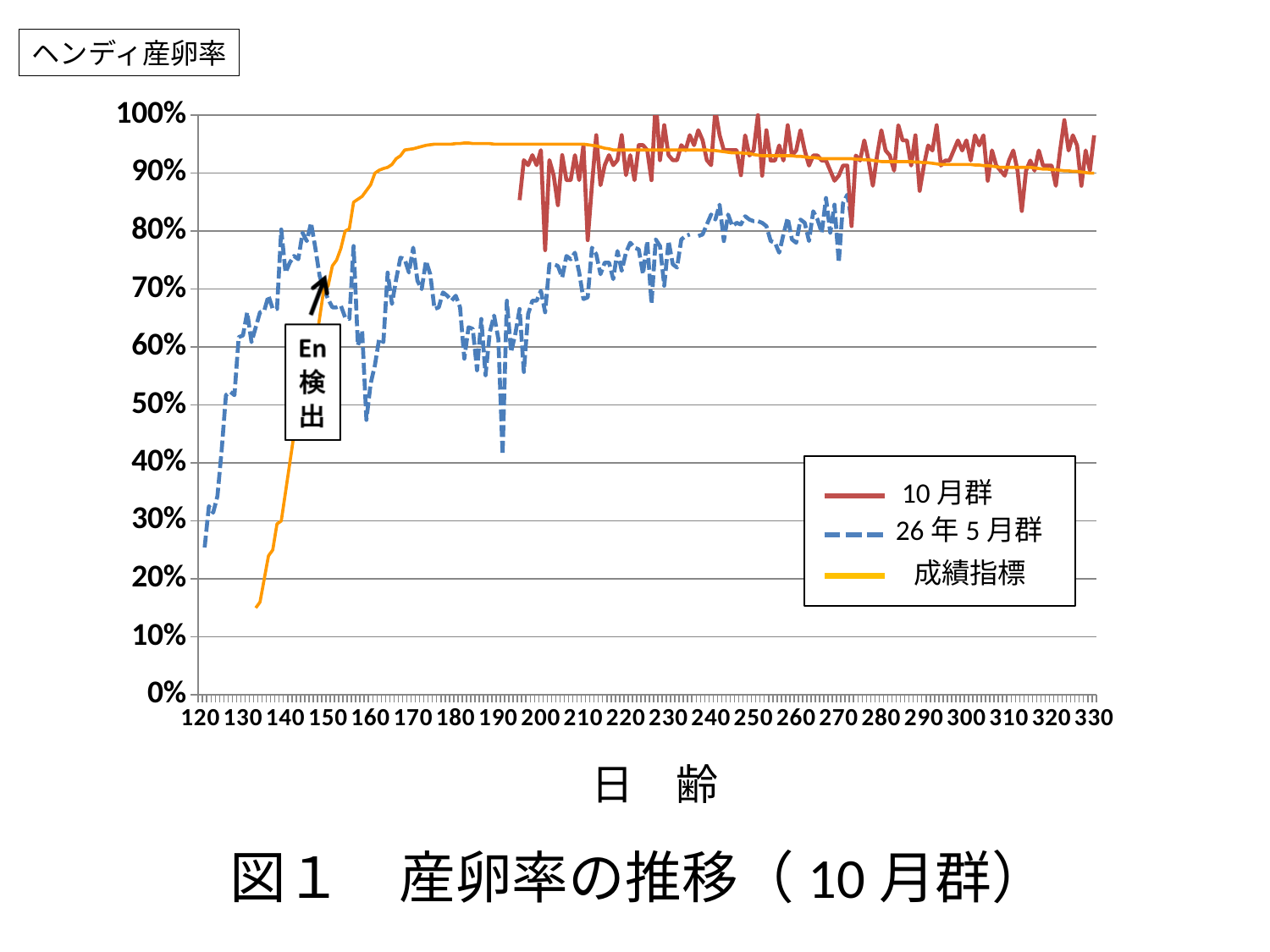
Is the value for 成績指標 at day 200 greater or less than 90%? greater What is the label of the x axis? 日齢 At day 250, which series has the higher value, 10月群 or 26年5月群? 10月群 Which series is drawn with a dashed line? 26年5月群 How many series does the legend list? 3 At day 140, which series has the higher value, 26年5月群 or 成績指標? 26年5月群 Is the lowest value for 26年5月群 around day 190 greater or less than 50%? less What kind of chart is shown on the slide? line chart Is the value for 10月群 at day 300 greater or less than 90%? greater Does the 成績指標 line rise or fall between day 134 and day 170? rise